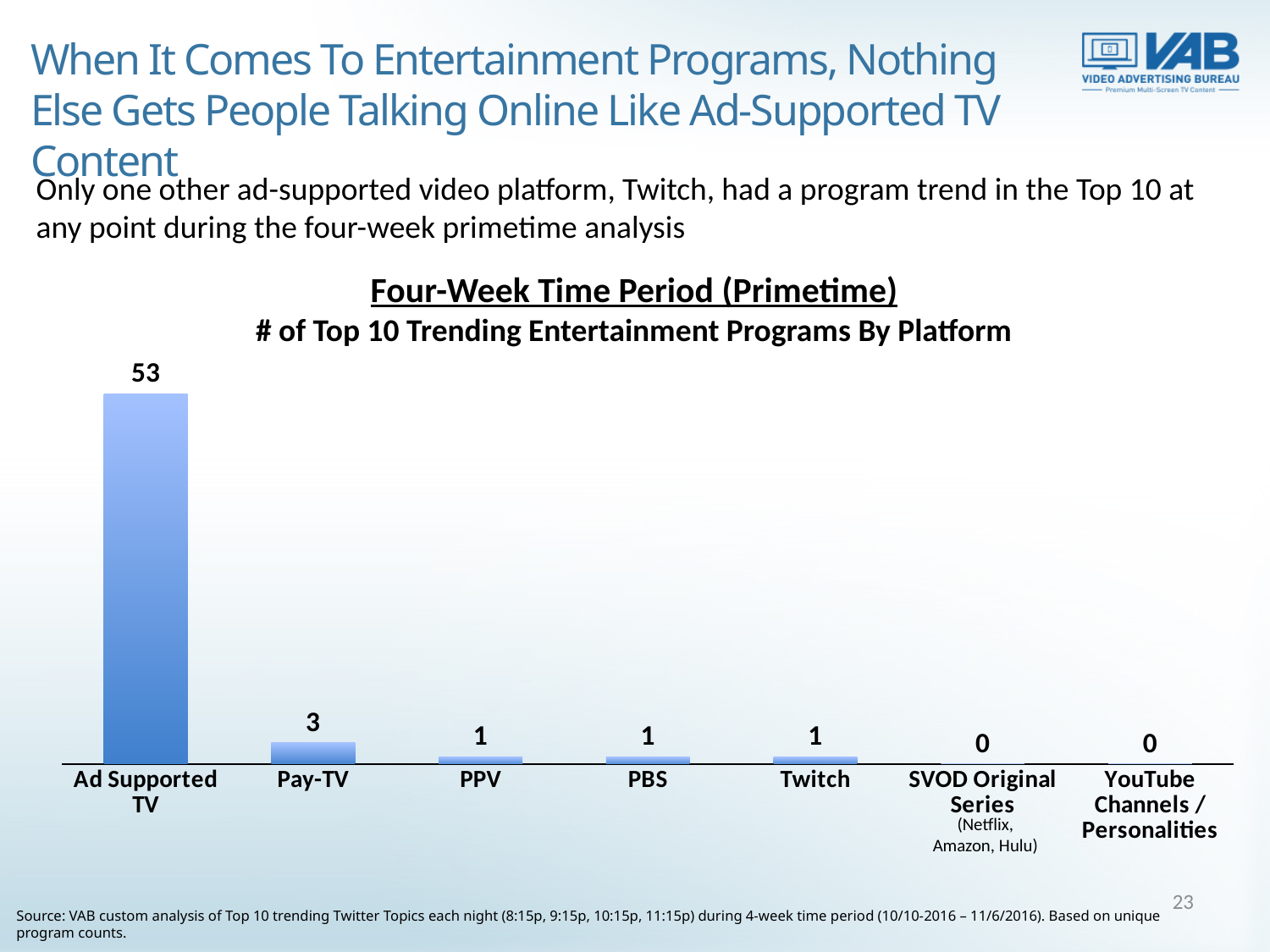
Which is larger, the value for Pay-TV or the value for PPV? Pay-TV What is the difference between the values for Pay-TV and PBS? 2 What is the difference between the values for Ad Supported TV and Pay-TV? 50 What is the value for Twitch? 1 Which platform has the highest number of Top 10 trending entertainment programs? Ad Supported TV What kind of chart is shown on the slide? Bar chart How many platforms have a value of 0? 2 What is the value for SVOD Original Series? 0 What is the value for Ad Supported TV? 53 How many platforms are shown on the x axis? 7 What is the title of the chart? Four-Week Time Period (Primetime) # of Top 10 Trending Entertainment Programs By Platform What is the value for Pay-TV? 3